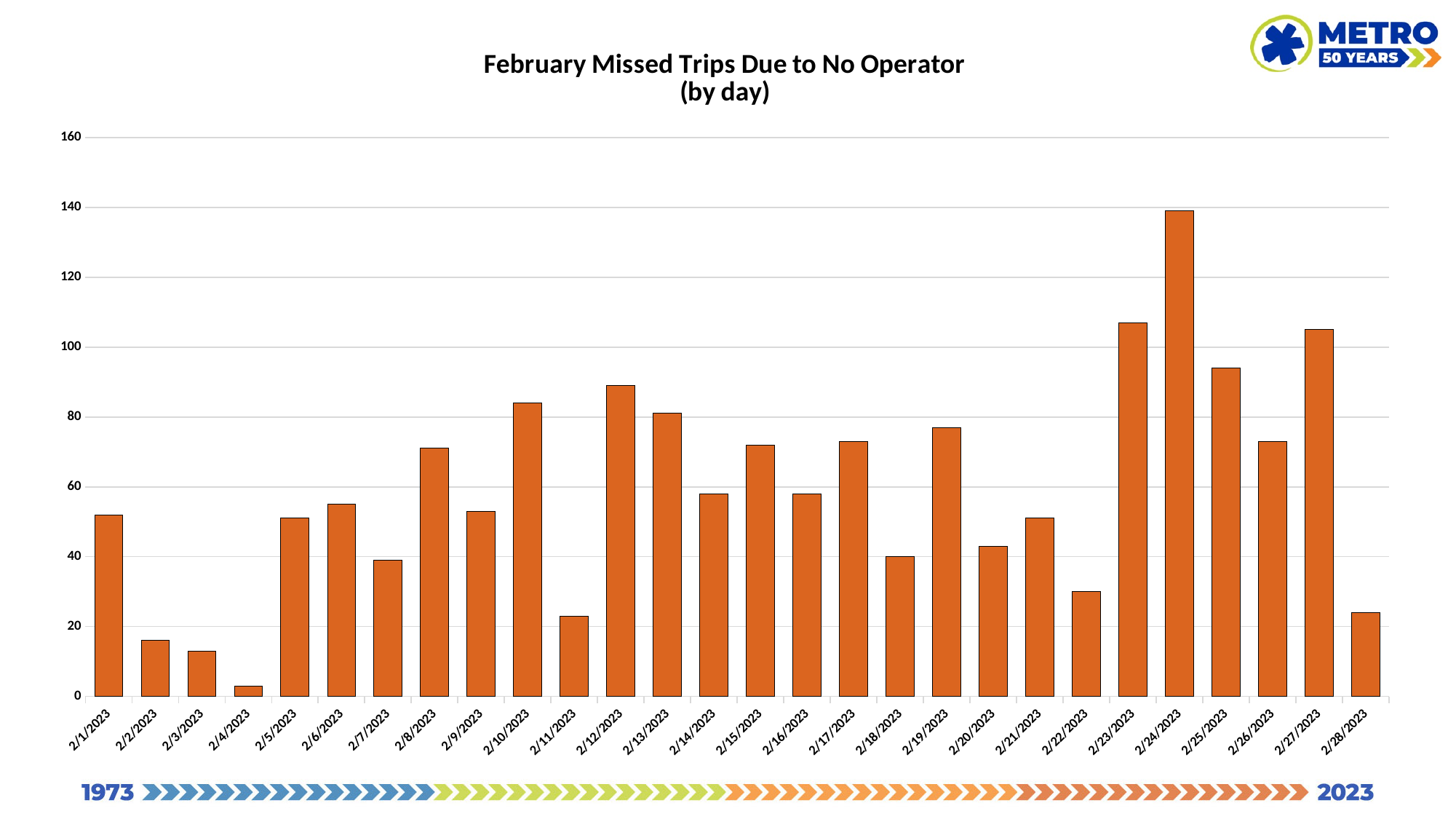
Is the value for 2/22/2023 greater or less than 40? less Which day has more missed trips, 2/23/2023 or 2/24/2023? 2/24/2023 How many days (bars) are plotted on the chart? 28 Which day has more missed trips, 2/12/2023 or 2/13/2023? 2/12/2023 Is the value for 2/23/2023 greater or less than 100? greater What kind of chart is shown on the slide? bar chart Which day has the lowest number of missed trips? 2/4/2023 Is the value for 2/4/2023 greater or less than 20? less Which day has the highest number of missed trips? 2/24/2023 Do the values rise or fall from 2/1/2023 to 2/4/2023? fall What is the title of the chart? February Missed Trips Due to No Operator (by day)